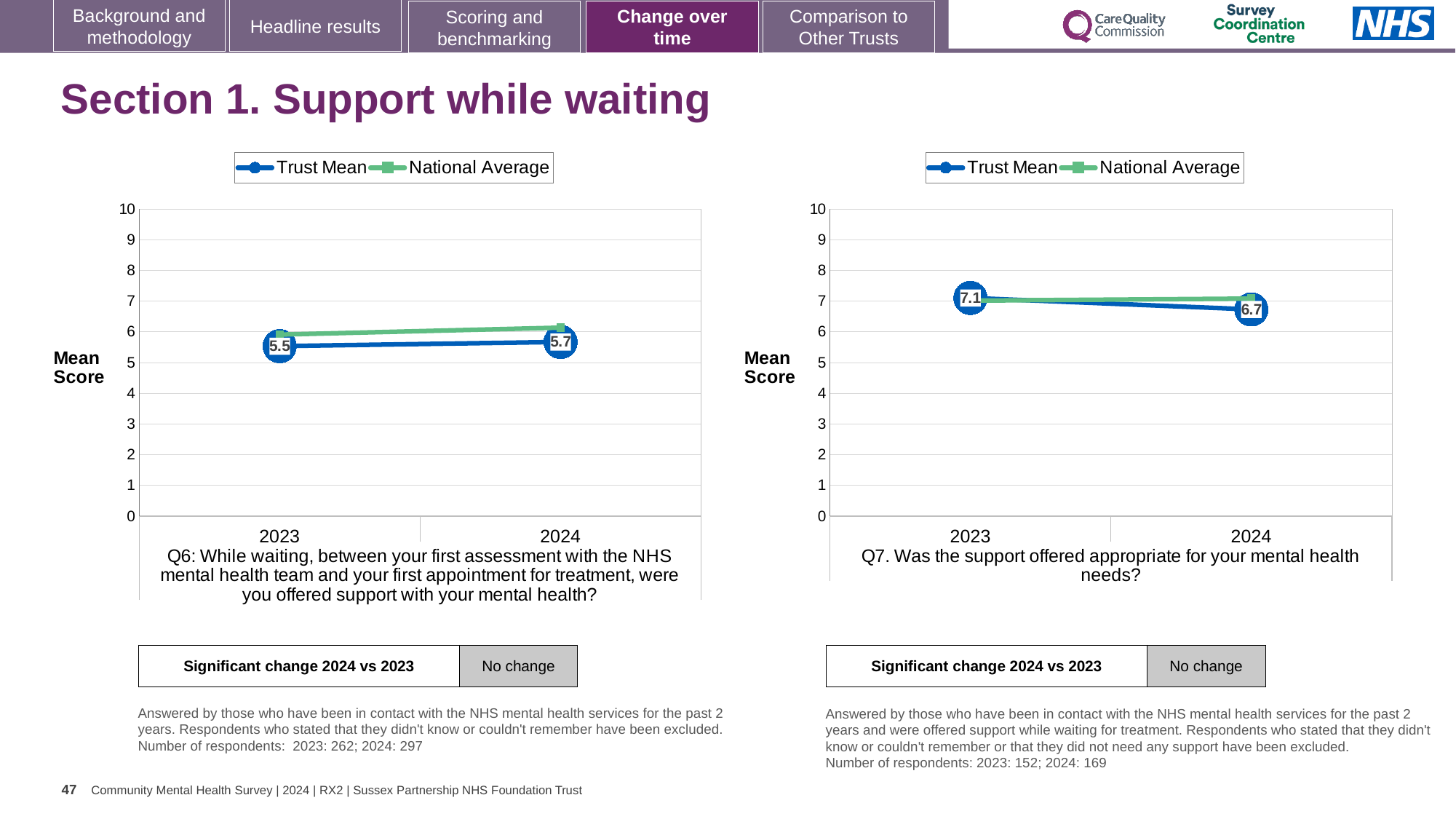
How many years are shown on the x axis of the left chart (Q6)? 2 In the right chart (Q7), what is the Trust Mean for 2024? 6.7 In the left chart (Q6), what is the Trust Mean for 2024? 5.7 In the left chart (Q6), what is the Trust Mean for 2023? 5.5 In the left chart (Q6), by how much did the Trust Mean change from 2023 to 2024? 0.2 In the right chart (Q7), does the Trust Mean rise or fall from 2023 to 2024? fall How many series does the legend of the right chart (Q7) list? 2 In the right chart (Q7), is the National Average for 2024 greater or less than 6? greater In the left chart (Q6), does the Trust Mean rise or fall from 2023 to 2024? rise In the right chart (Q7), what is the difference between the Trust Mean in 2023 and in 2024? 0.4 What type of chart is used on the left of the slide (Q6)? line chart In the right chart (Q7), what is the Trust Mean for 2023? 7.1